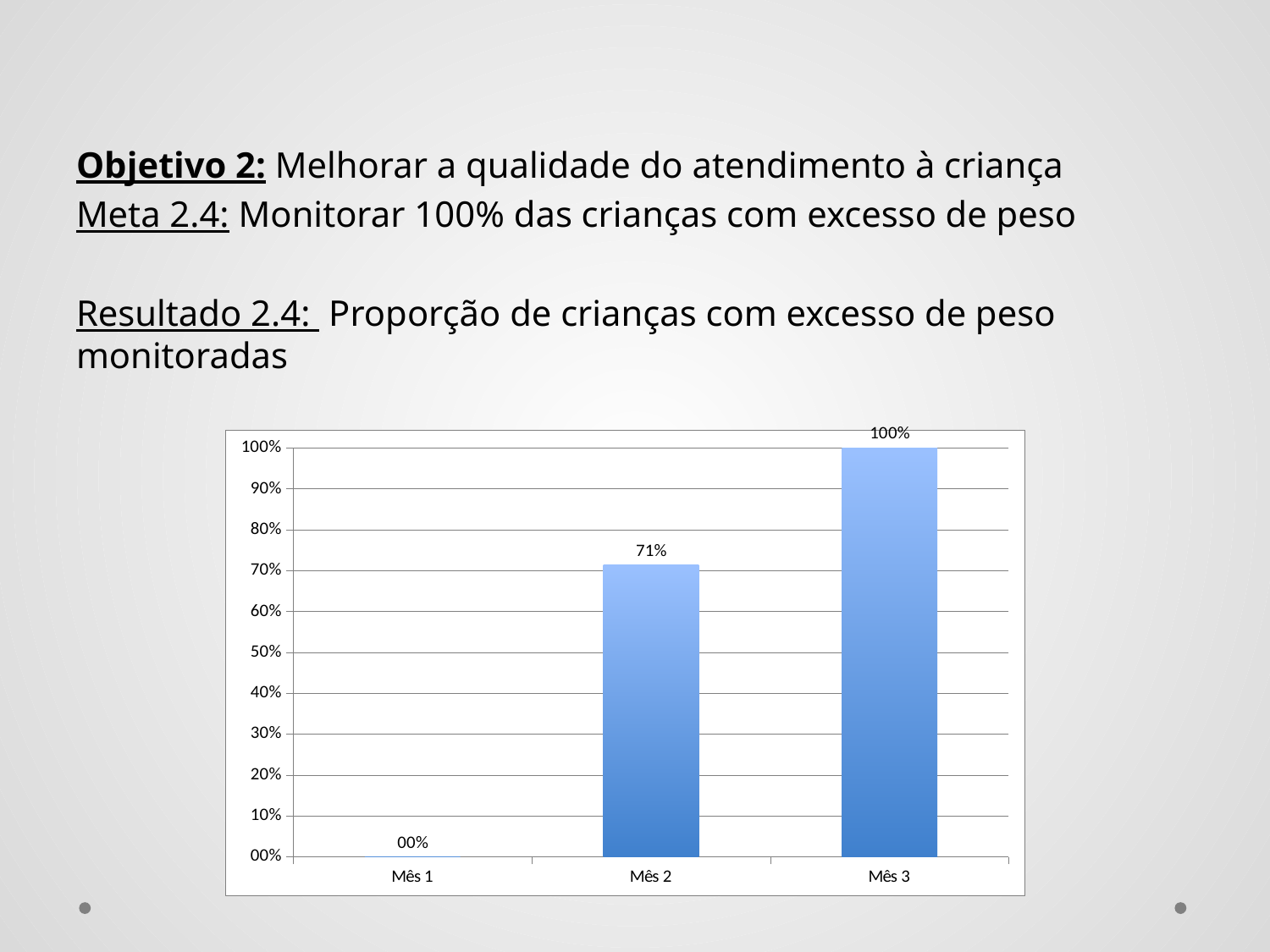
Is the value for Mês 2 greater or less than 60%? greater What is the value for Mês 1? 00% What is the value for Mês 2? 71% What is the highest tick value shown on the y axis? 100% What is the difference between the values for Mês 3 and Mês 2? 29% Which month has the lowest value? Mês 1 How many months are shown on the x axis? 3 What is the value for Mês 3? 100% What kind of chart is shown on the slide? bar chart Which is larger, the value for Mês 2 or the value for Mês 3? Mês 3 Which month has the highest value? Mês 3 Do the values rise or fall from Mês 1 to Mês 3? rise